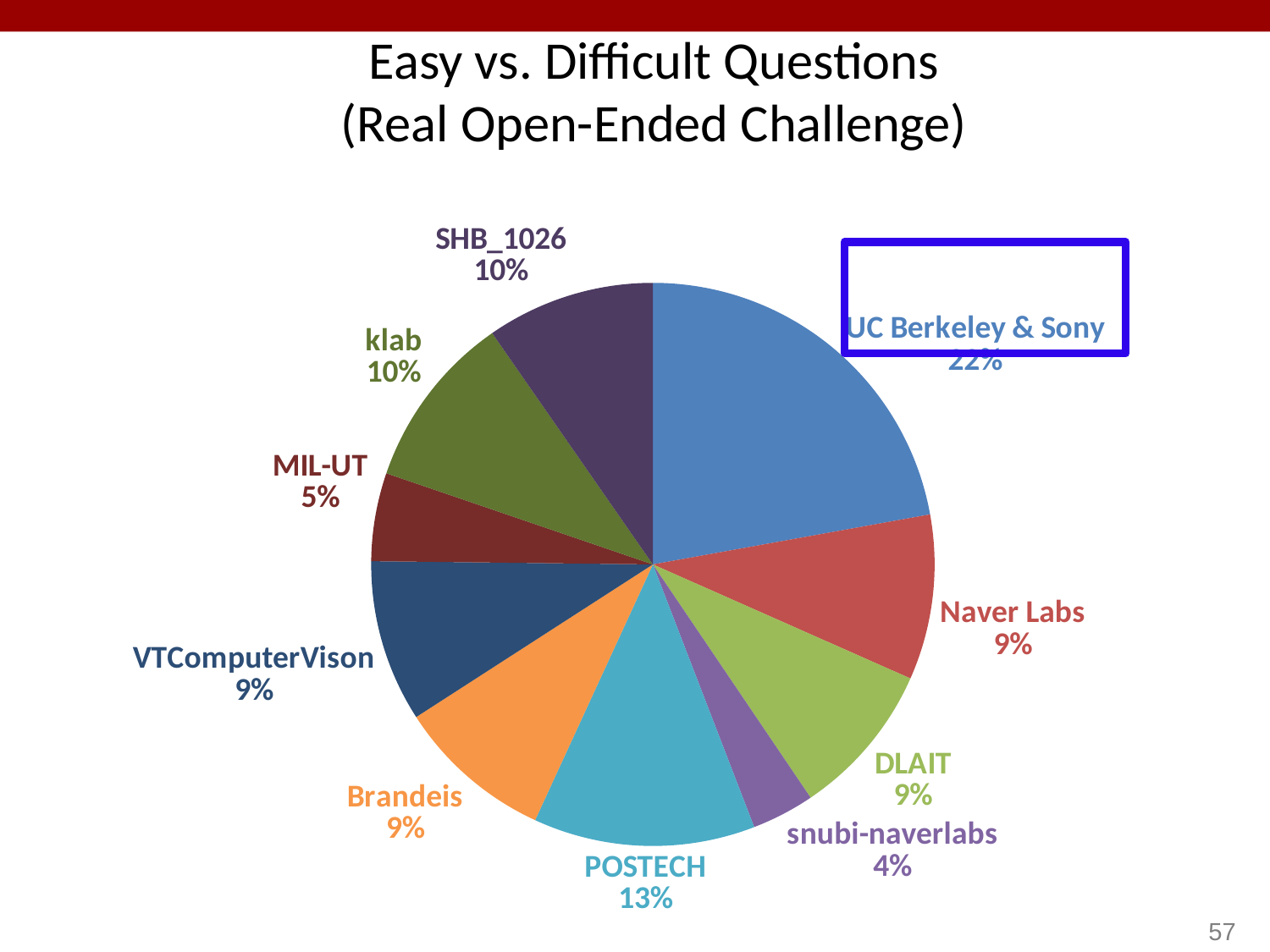
What is the title of the slide containing the pie chart? Easy vs. Difficult Questions (Real Open-Ended Challenge) What share of the pie does MIL-UT have? 5% Which team has the smallest slice of the pie? snubi-naverlabs What share of the pie does snubi-naverlabs have? 4% What is the difference between the shares of POSTECH and SHB_1026? 3% Which is larger, the share for klab or the share for MIL-UT? klab What share of the pie does POSTECH have? 13% Which team has the largest slice of the pie? UC Berkeley & Sony What kind of chart is shown on the slide? pie chart How many slices does the pie chart have? 10